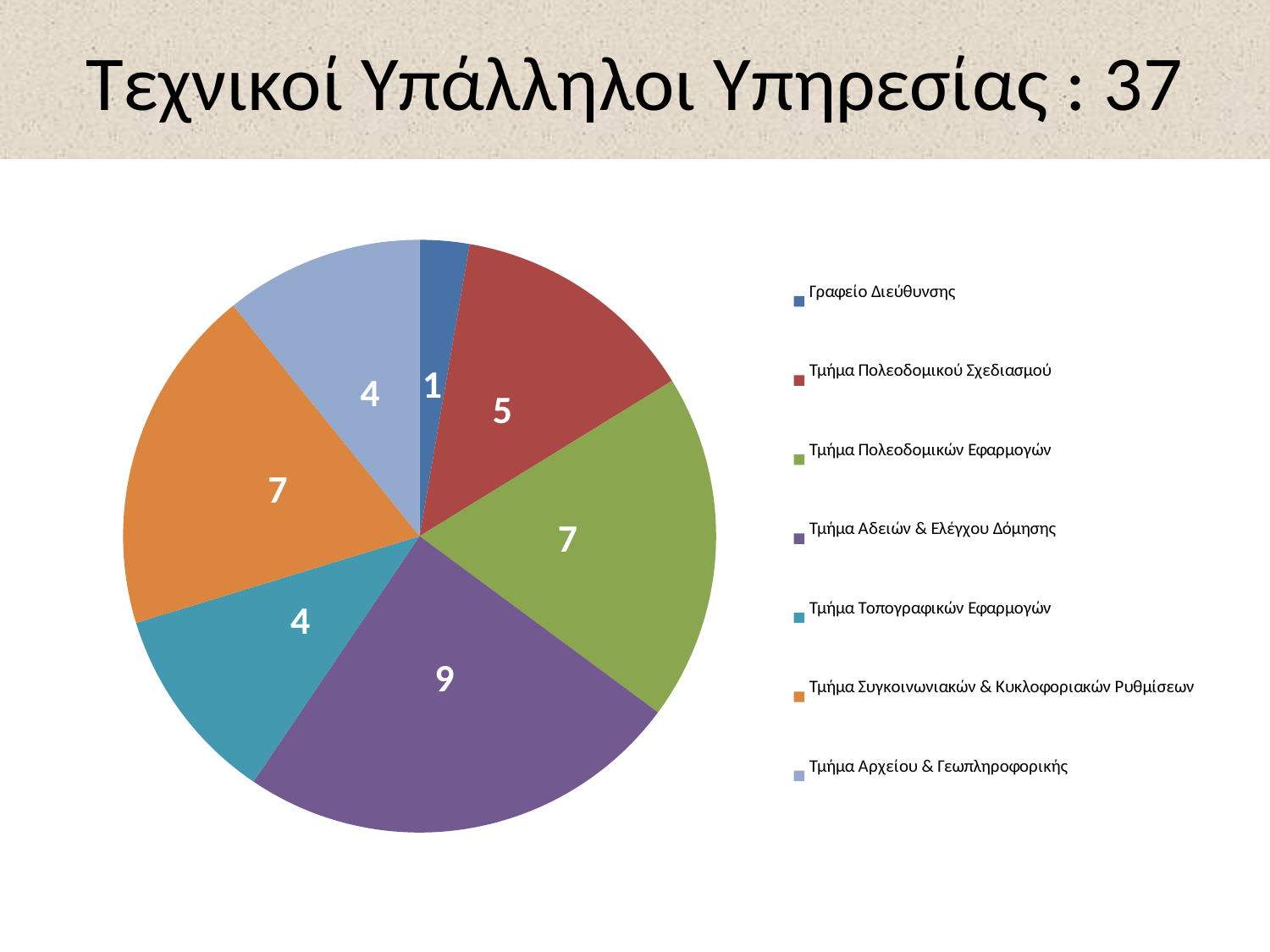
Which category has the largest slice of the pie? Τμήμα Αδειών & Ελέγχου Δόμησης What is the value for Τμήμα Αδειών & Ελέγχου Δόμησης? 9 What is the value for Τμήμα Πολεοδομικού Σχεδιασμού? 5 What is the difference between the values for Τμήμα Αδειών & Ελέγχου Δόμησης and Τμήμα Πολεοδομικού Σχεδιασμού? 4 What type of chart is shown on the slide? pie chart What is the title of the slide containing the pie chart? Τεχνικοί Υπάλληλοι Υπηρεσίας : 37 What is the value for Γραφείο Διεύθυνσης? 1 Which category has the smallest slice of the pie? Γραφείο Διεύθυνσης How many slices does the pie chart have? 7 Which is larger, the value for Τμήμα Πολεοδομικών Εφαρμογών or the value for Τμήμα Αρχείου & Γεωπληροφορικής? Τμήμα Πολεοδομικών Εφαρμογών What is the value for Τμήμα Τοπογραφικών Εφαρμογών? 4 What colour is the slice for Τμήμα Συγκοινωνιακών & Κυκλοφοριακών Ρυθμίσεων? orange